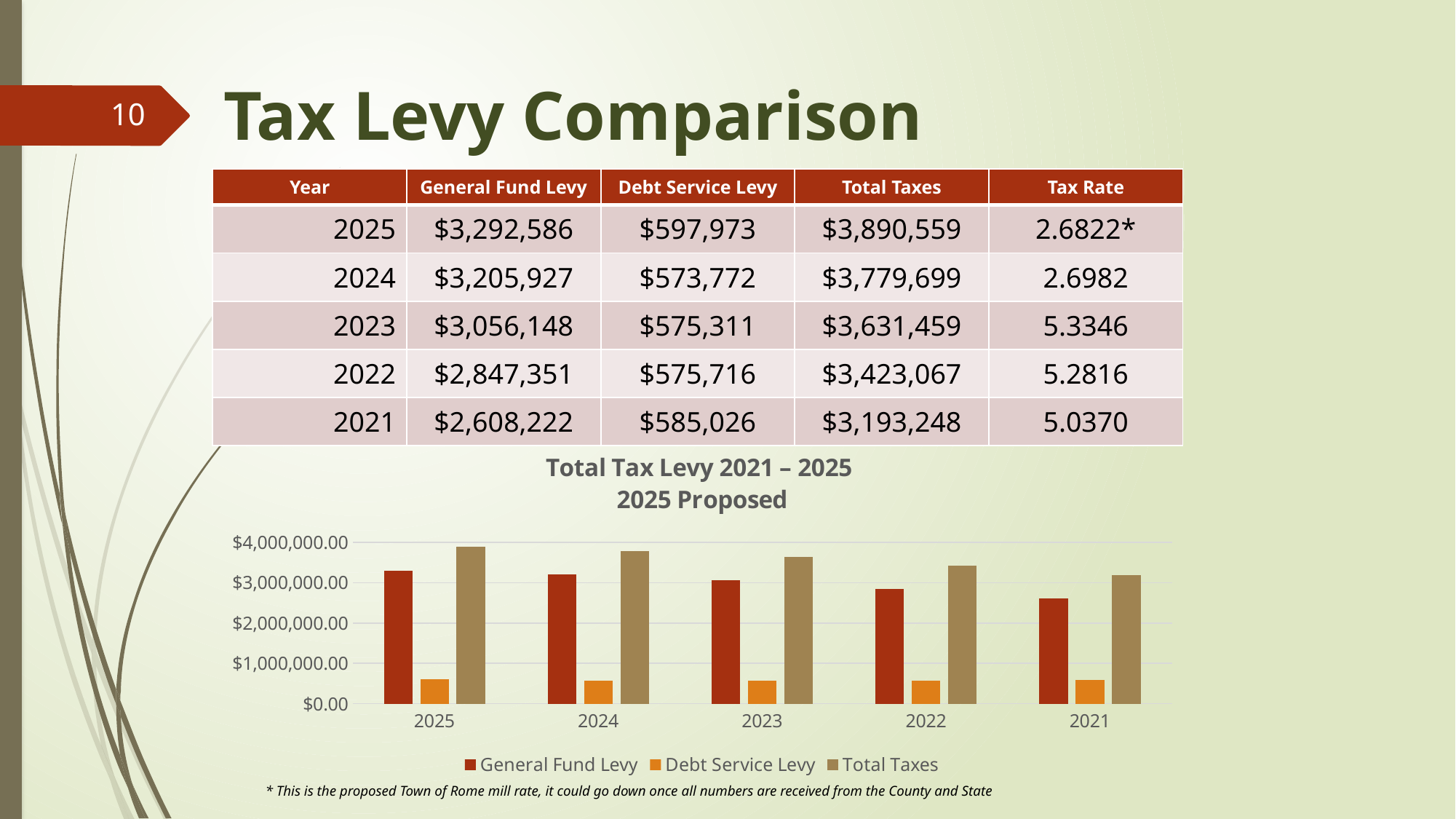
How many series does the legend of the Total Tax Levy chart list? 3 In the Total Tax Levy chart, is the General Fund Levy for 2025 greater or less than $3,000,000.00? greater In the Total Tax Levy chart, is the General Fund Levy for 2021 greater or less than $3,000,000.00? less In the Total Tax Levy chart, which year has the lowest General Fund Levy bar? 2021 In the Total Tax Levy chart, is the Debt Service Levy for 2023 greater or less than $1,000,000.00? less In the Total Tax Levy chart, do the General Fund Levy bars rise or fall moving left to right from 2025 to 2021? fall What kind of chart is shown below the table on the slide? bar chart By how much do the Total Taxes for 2025 exceed the Total Taxes for 2024, using the values printed on the slide? $110,860 In the Total Tax Levy chart, which year has the highest Total Taxes bar? 2025 In the Total Tax Levy chart, which is larger for 2023: the General Fund Levy or the Debt Service Levy? General Fund Levy What is the Total Taxes value for 2024 shown on the slide? $3,779,699 How many years are shown on the x axis of the Total Tax Levy chart? 5